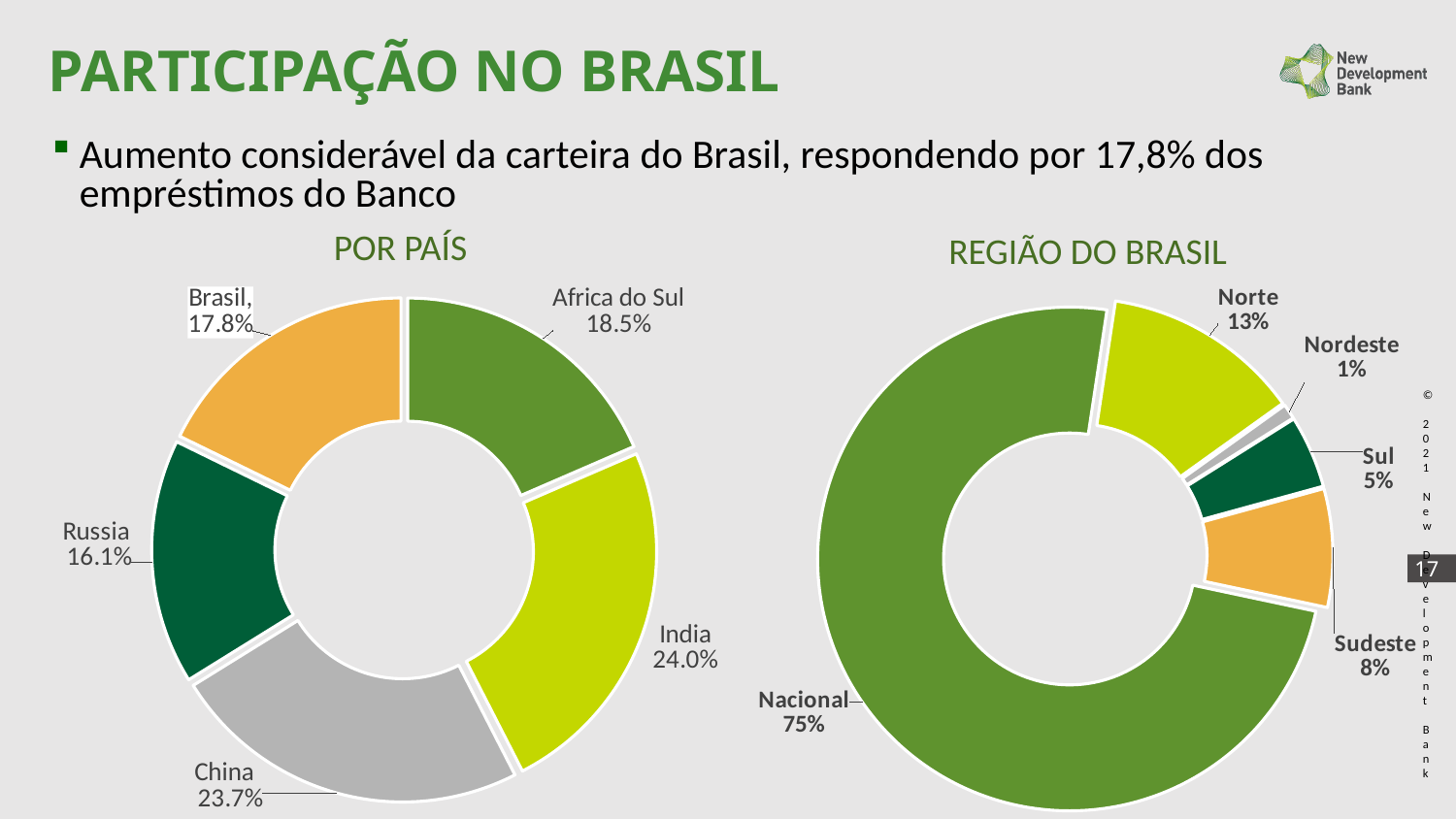
In the REGIÃO DO BRASIL chart, what share does Sul have? 5% In the REGIÃO DO BRASIL chart, what is the difference between the shares of Norte and Sudeste? 5% In the POR PAÍS chart, which country has the smallest share? Russia In the REGIÃO DO BRASIL chart, which region has the smallest share? Nordeste In the POR PAÍS chart, what is the difference between the shares of Africa do Sul and Russia? 2.4% In the POR PAÍS chart, what share does Brasil have? 17.8% In the POR PAÍS chart, what share does India have? 24.0% In the REGIÃO DO BRASIL chart, what share does Nacional have? 75% What kind of chart is the REGIÃO DO BRASIL chart? Doughnut (pie) chart In the POR PAÍS chart, which country has the largest share? India How many countries are shown in the POR PAÍS chart? 5 In the POR PAÍS chart, which has a larger share, China or Brasil? China